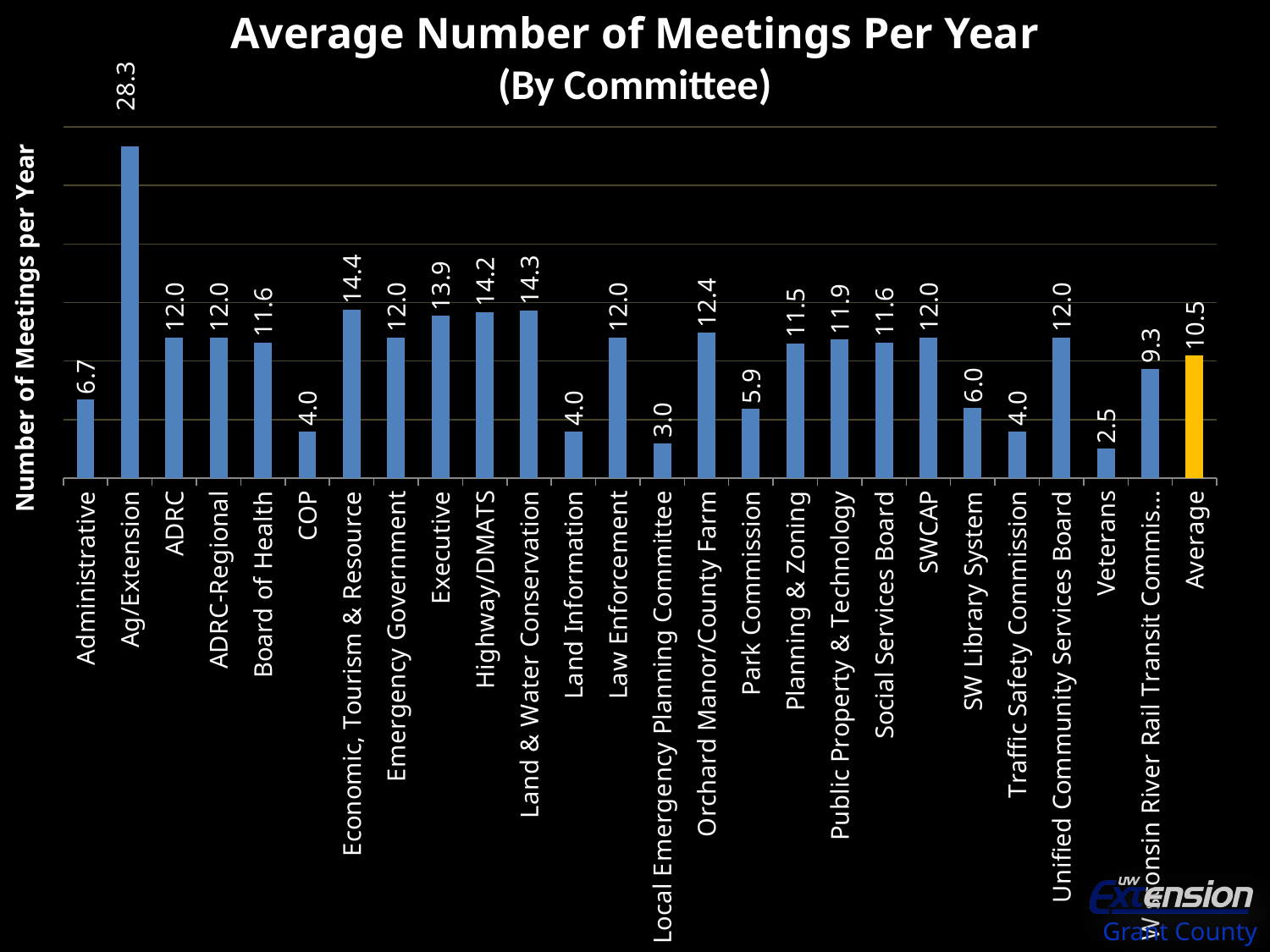
How many bars are plotted in the chart, including the Average bar? 26 What is the value shown for the Average bar? 10.5 What kind of chart is shown on the slide? Bar chart Which has a higher value, Executive or Highway/DMATS? Highway/DMATS Which committee has the highest average number of meetings per year? Ag/Extension What is the difference between the values for Economic, Tourism & Resource and Land Information? 10.4 What is the value shown for the Veterans committee? 2.5 How much higher is the Ag/Extension value than the Average value? 17.8 What is the value shown for Park Commission? 5.9 What is the average number of meetings per year for the Ag/Extension committee? 28.3 Which bar is shown in a different colour (yellow) from the rest? Average Which committee has the lowest average number of meetings per year? Veterans